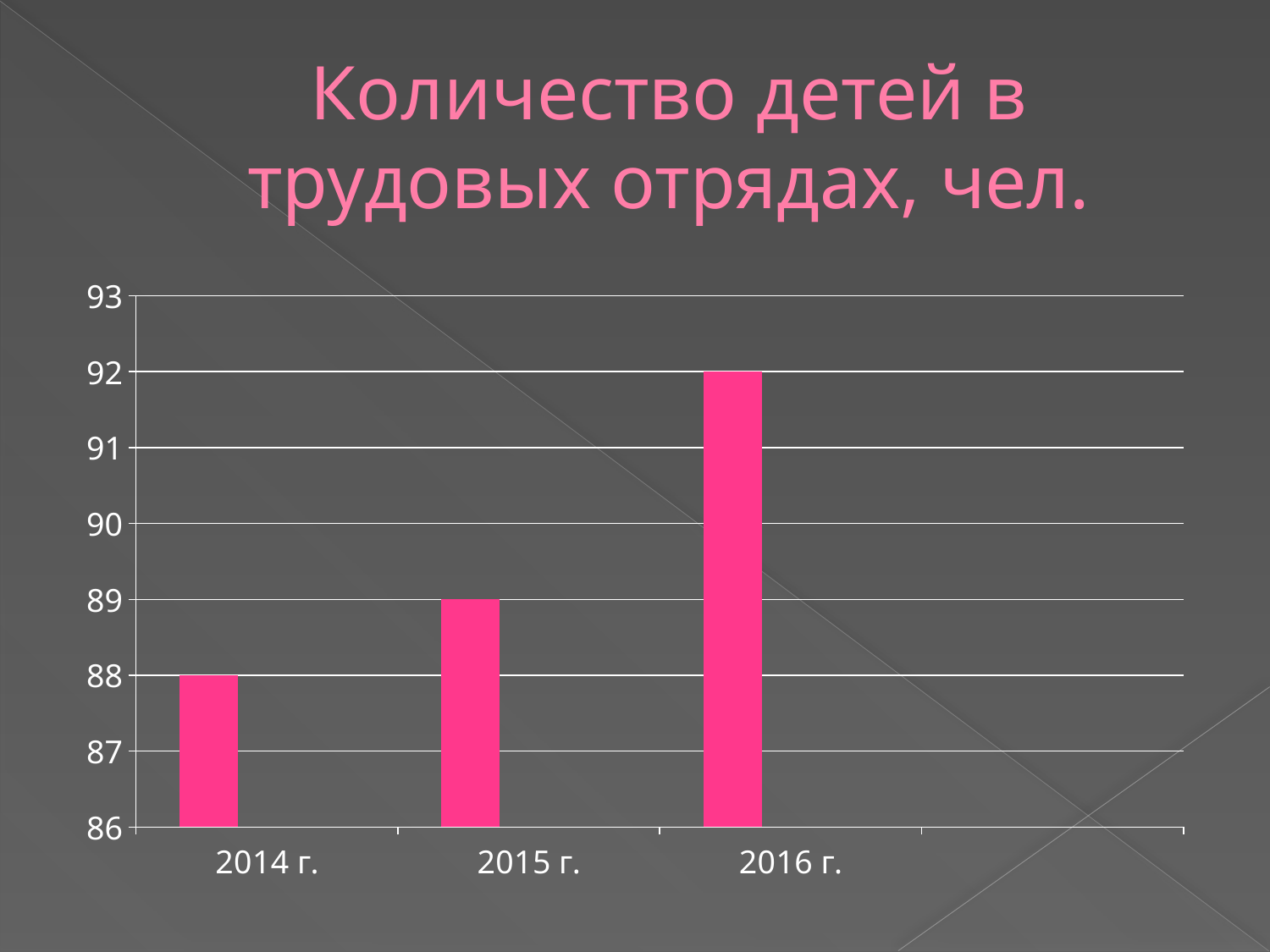
Do the values rise or fall from 2014 г. to 2016 г.? rise What is the difference between the values for 2016 г. and 2014 г.? 4 What is the value for 2014 г.? 88 What is the value for 2016 г.? 92 Which year has the lowest value? 2014 г. Which is larger, the value for 2015 г. or the value for 2016 г.? 2016 г. Which year has the highest value? 2016 г. What is the difference between the values for 2015 г. and 2014 г.? 1 What kind of chart is shown on the slide? bar chart What is the value for 2015 г.? 89 How many years are shown on the x axis? 3 Is the value for 2016 г. greater or less than 90? greater